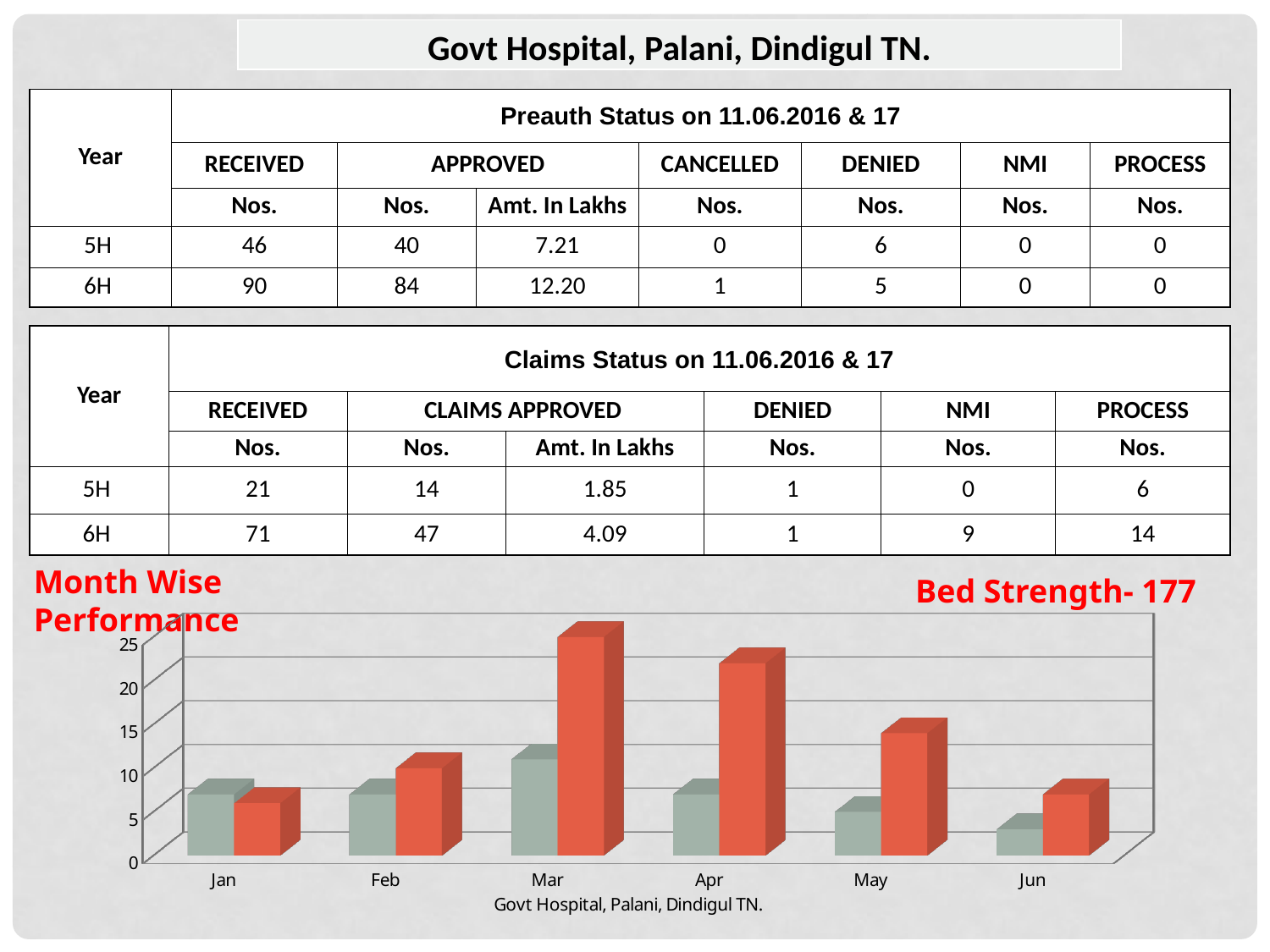
Do the red bars rise or fall from Mar to Jun? fall What kind of chart is shown at the bottom of the slide? bar chart In which month is the grey bar the shortest? Jun What text appears as the axis title below the month labels? Govt Hospital, Palani, Dindigul TN. How many bars are plotted for each month in the chart? 2 How many months are shown on the x axis of the chart? 6 Which is taller in Mar, the red bar or the grey bar? the red bar Is the red bar for Apr greater or less than 20? greater In which month is the red bar the tallest? Mar Is the grey bar for Jun greater or less than 5? less In which month is the grey bar the tallest? Mar Is the red bar for May greater or less than 10? greater